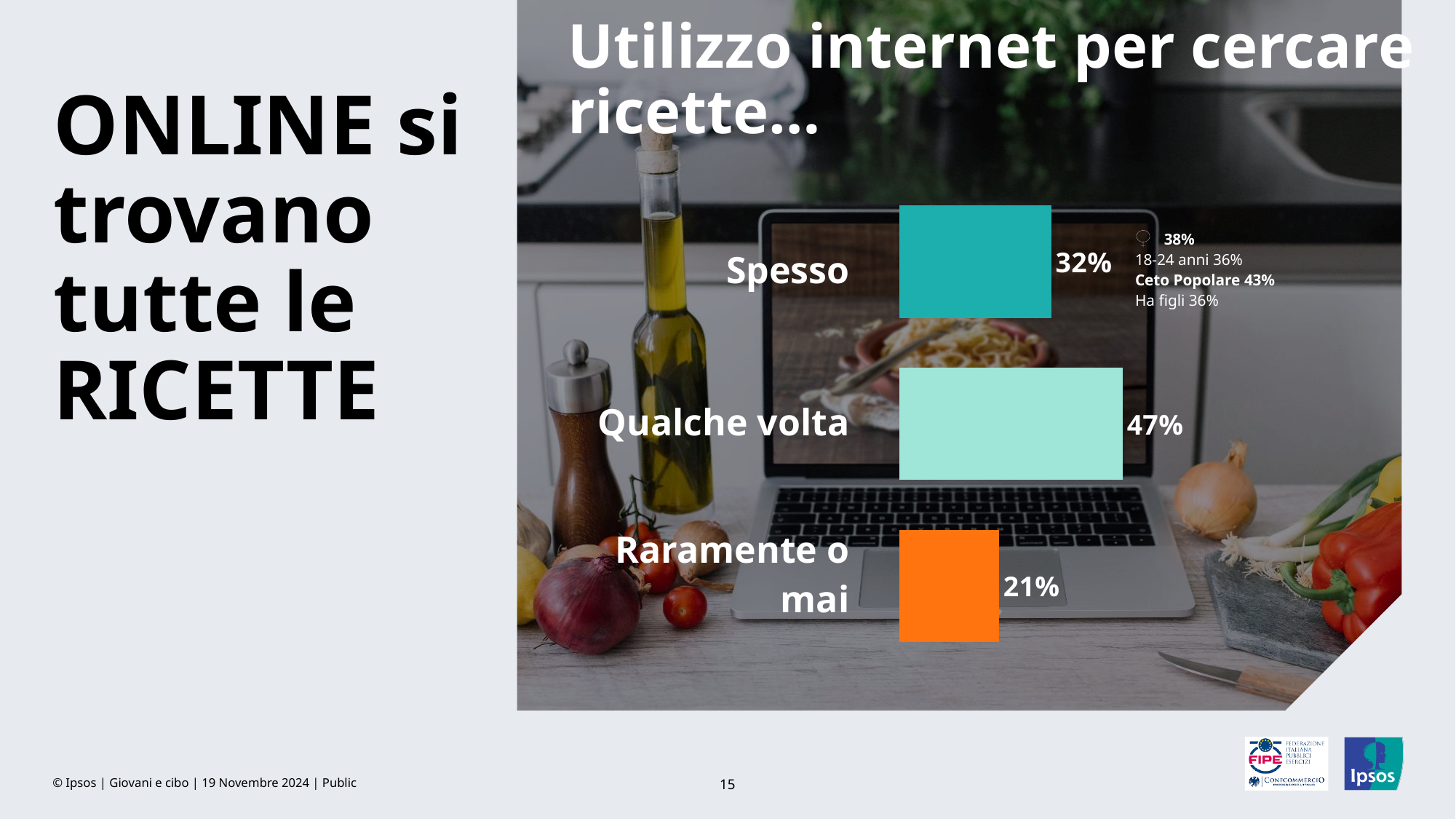
What colour is the bar for "Raramente o mai"? Orange Which category has the lowest value? Raramente o mai What is the value for "Raramente o mai"? 21% What is the title of the chart? Utilizzo internet per cercare ricette... How many categories does the chart show? 3 What is the difference between the values for "Qualche volta" and "Spesso"? 15% Which category has the highest value? Qualche volta Which is larger, the value for "Spesso" or the value for "Raramente o mai"? Spesso What is the difference between the values for "Spesso" and "Raramente o mai"? 11% What is the value for "Qualche volta"? 47% What is the value for "Spesso"? 32% What kind of chart is shown on the slide? Bar chart